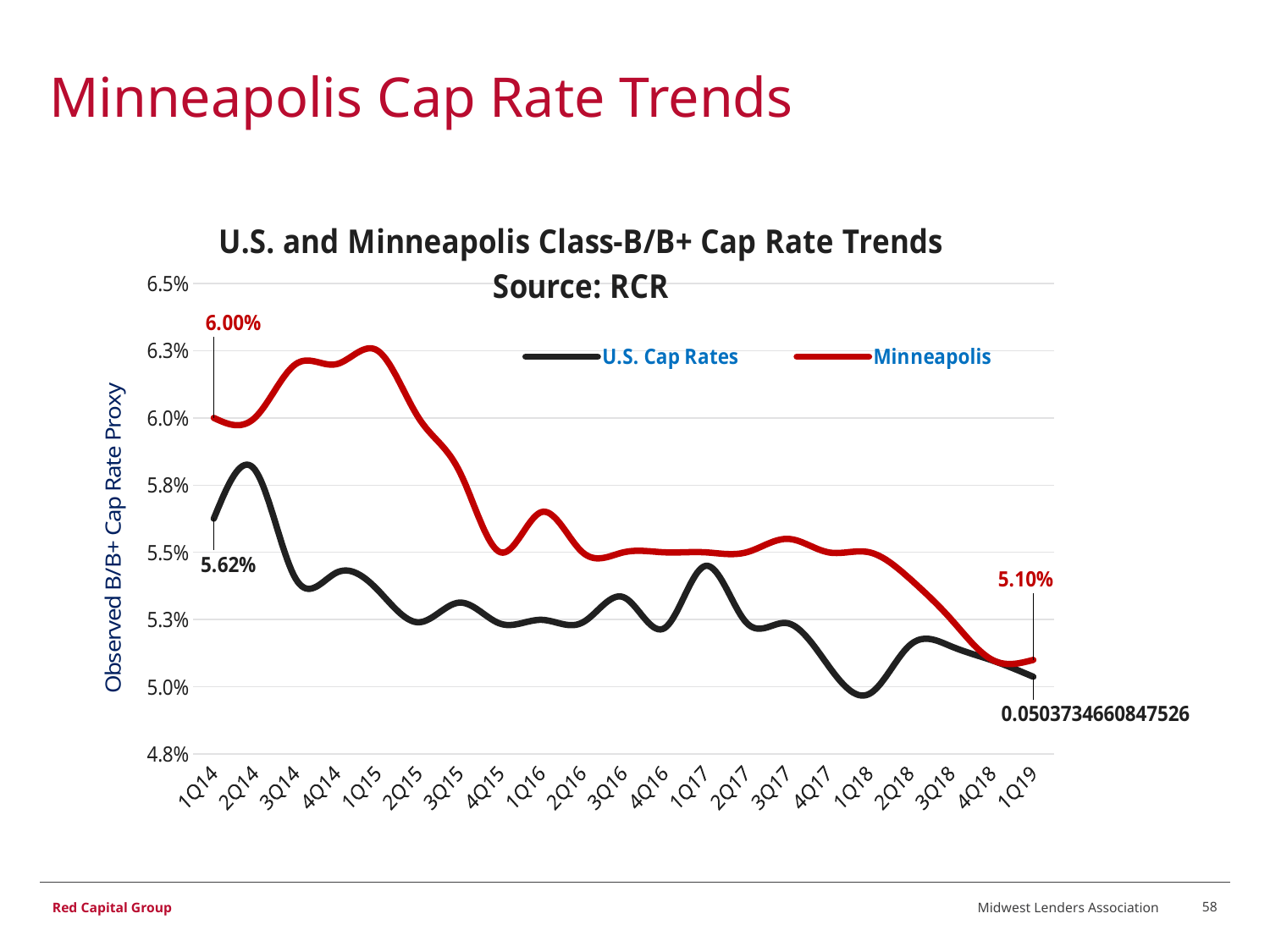
What kind of chart is shown on the slide? Line chart How many series does the legend list? 2 By how many percentage points does the Minneapolis value exceed the U.S. Cap Rates value at 1Q14? 0.38 percentage points Does the Minneapolis series rise or fall overall from 1Q14 to 1Q19? Fall What is the Minneapolis cap rate value labeled at 1Q19? 5.10% Is the U.S. Cap Rates value at 1Q18 greater or less than 5.3%? less How many quarters are shown on the x axis? 21 At 1Q14, which series has the higher value, U.S. Cap Rates or Minneapolis? Minneapolis What is the U.S. Cap Rates value labeled at 1Q19? 0.0503734660847526 What is the U.S. Cap Rates value labeled at 1Q14? 5.62% Is the Minneapolis value at 1Q15 greater or less than 6.0%? greater What is the Minneapolis cap rate value labeled at 1Q14? 6.00%